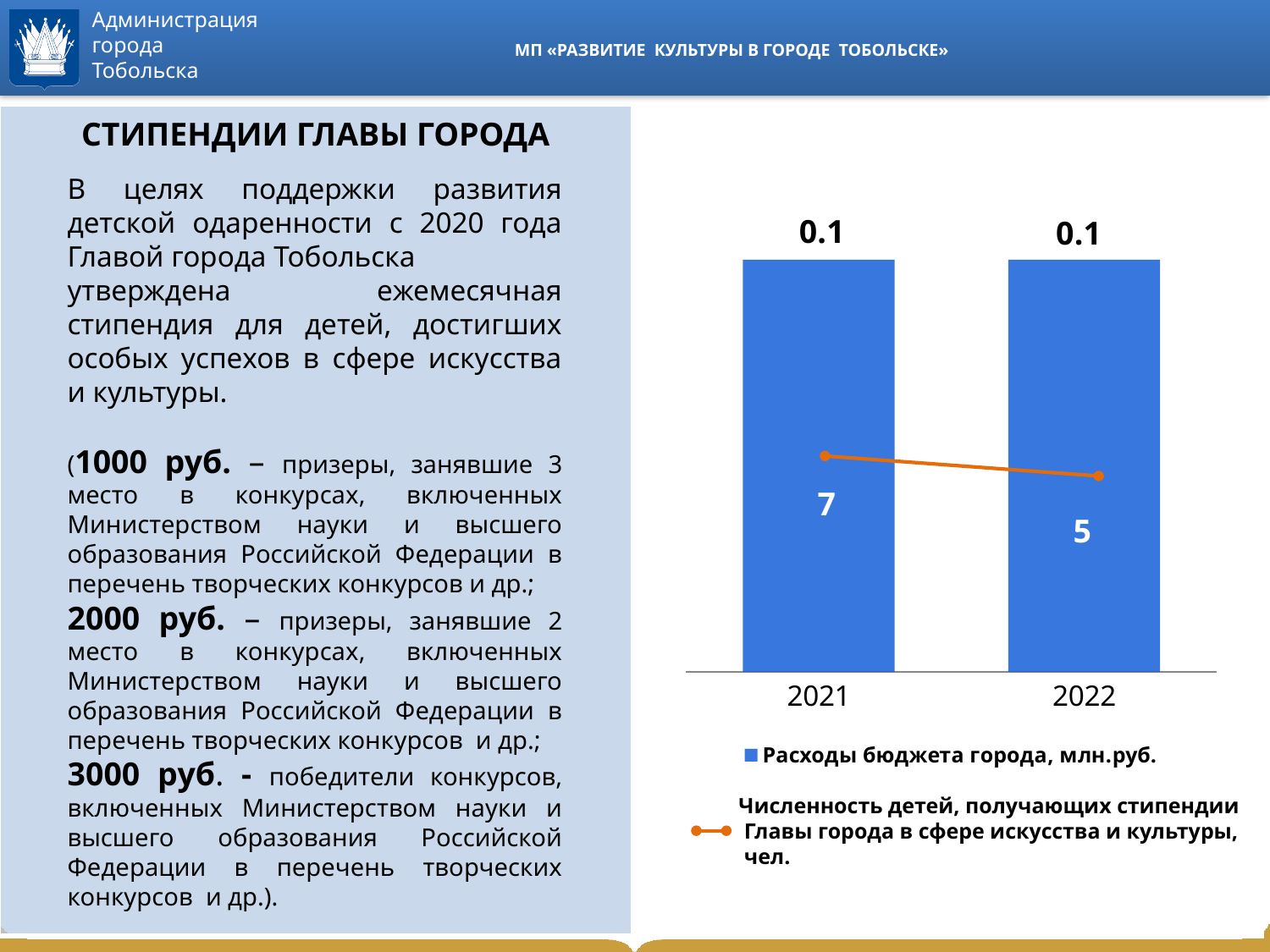
How many children received the Head of City scholarship (Численность детей, получающих стипендии) in 2021? 7 What colour are the bars representing 'Расходы бюджета города, млн.руб.'? blue What is the value of 'Расходы бюджета города, млн.руб.' for 2022? 0.1 In which year was the number of children receiving the scholarship highest? 2021 Does the number of children receiving the scholarship rise or fall from 2021 to 2022? fall How many children received the Head of City scholarship (Численность детей, получающих стипендии) in 2022? 5 How many series does the chart legend list? 2 What is the value of 'Расходы бюджета города, млн.руб.' for 2021? 0.1 In which year was the number of children receiving the scholarship lowest? 2022 How many years (categories) are shown on the x axis of the chart? 2 Which year had more children receiving the scholarship, 2021 or 2022? 2021 What is the difference between the number of children receiving the scholarship in 2021 and in 2022? 2